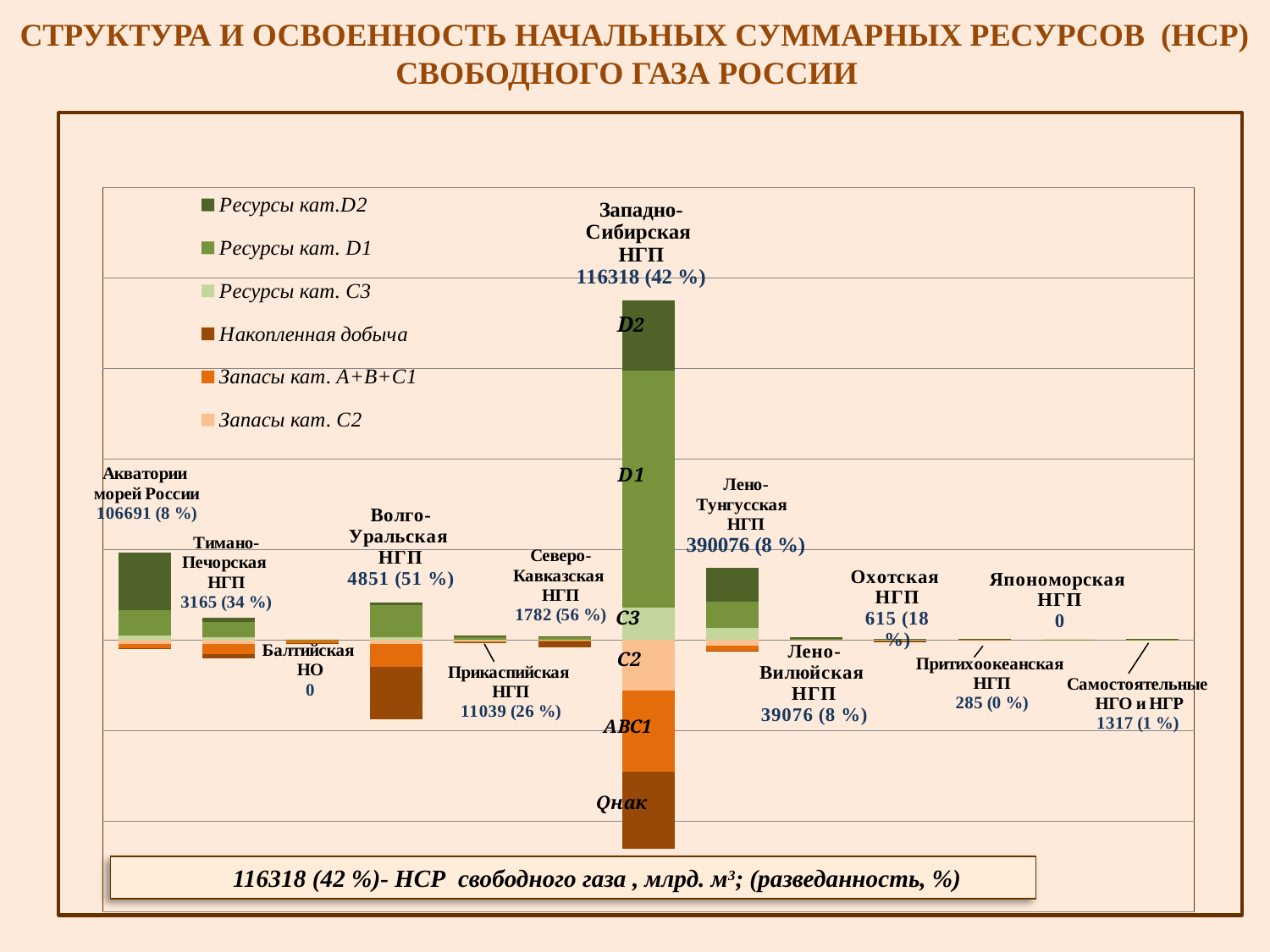
How many series does the legend list? 6 What explored-share percentage is shown for Северо-Кавказская НГП? 56 % What is the labelled value for Прикаспийская НГП? 11039 (26 %) Which has the larger labelled value: Лено-Вилюйская НГП or Охотская НГП? Лено-Вилюйская НГП What is the labelled value for Волго-Уральская НГП? 4851 (51 %) Which category has the tallest stacked bar? Западно-Сибирская НГП What value is shown for Балтийская НО? 0 What is the labelled value for Акватории морей России? 106691 (8 %) What kind of chart is shown on the slide? Stacked bar chart What is the labelled NSR value for Западно-Сибирская НГП? 116318 (42 %) What is the difference between the labelled values of Волго-Уральская НГП (4851) and Тимано-Печорская НГП (3165)? 1686 Which legend entry is shown with the darkest green colour? Ресурсы кат.D2